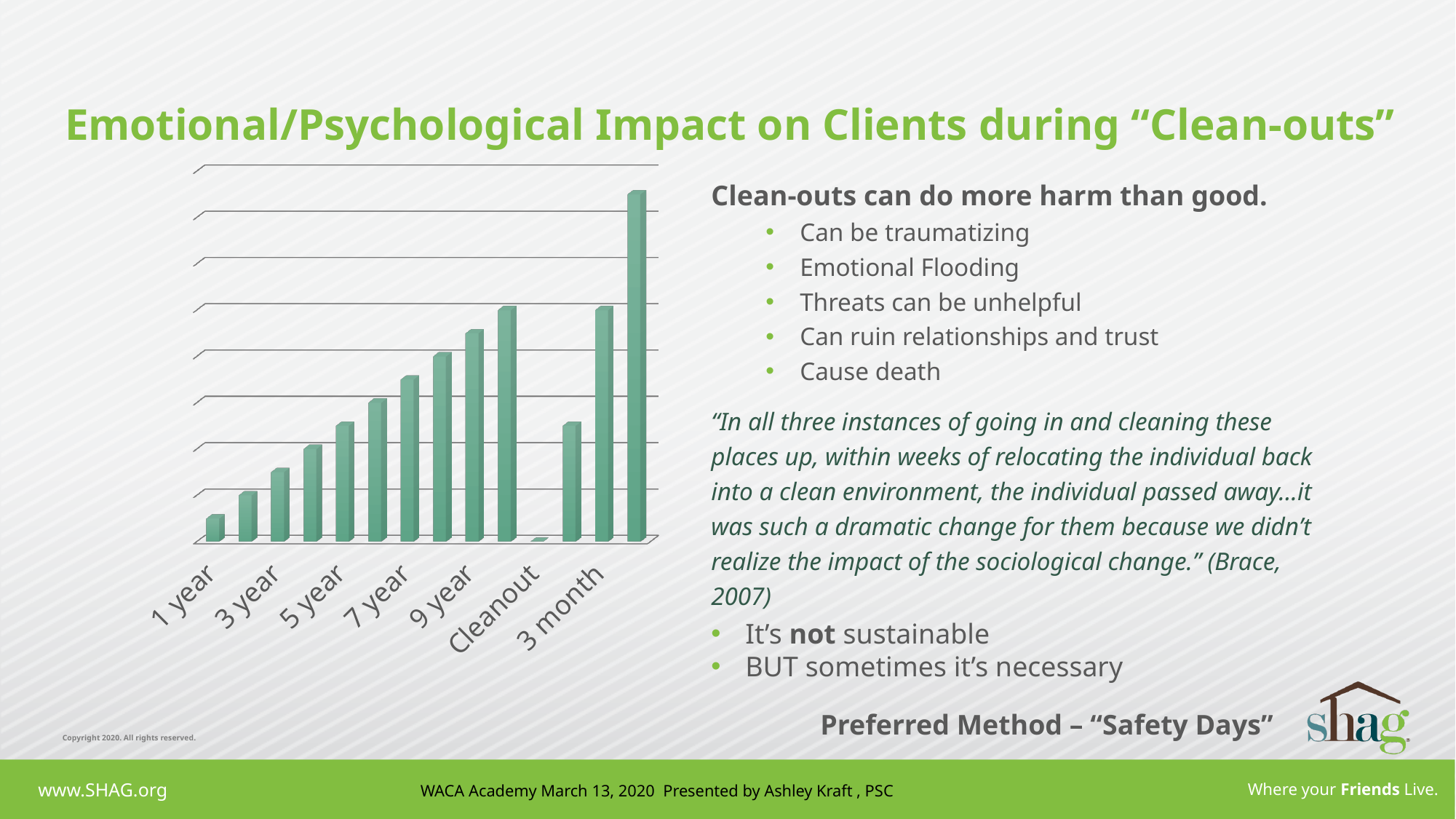
How many category labels are shown on the x axis of the chart? 7 Do the bars rise or fall from 1 year to 9 year on the chart? rise Which has the taller bar on the chart, 1 year or 9 year? 9 year Which has the taller bar on the chart, Cleanout or 3 month? 3 month What is the first category label on the x axis of the chart? 1 year What colour are the bars in the chart? green Which has the taller bar on the chart, 3 year or 7 year? 7 year Which labeled category on the chart has the lowest bar? Cleanout What kind of chart is shown on the slide? bar chart